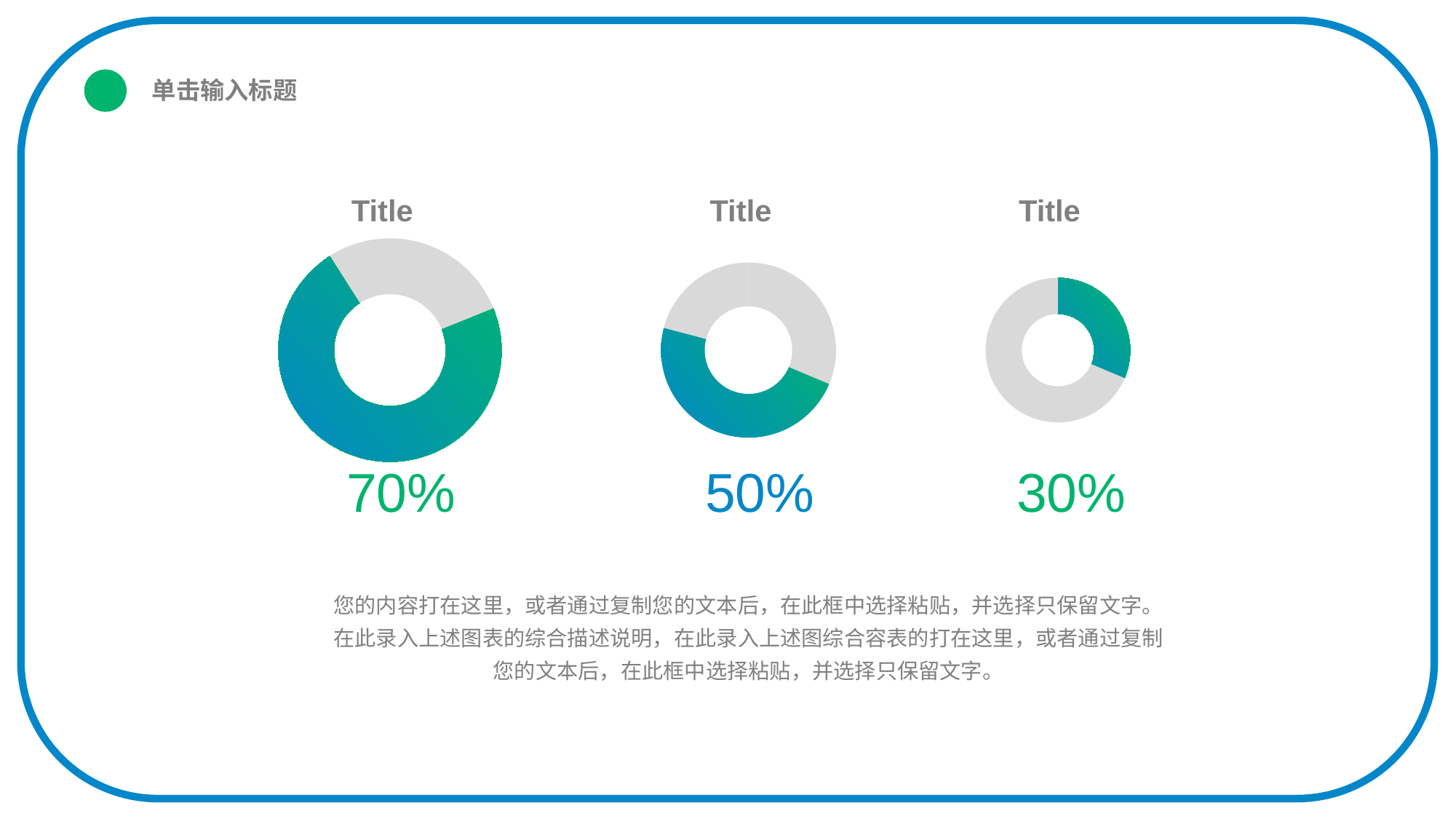
What kind of chart is used for the three charts on the slide? donut chart Which of the three donut charts shows the lowest percentage: left, middle or right? right Which of the three donut charts shows the highest percentage: left, middle or right? left What percentage is shown below the middle donut chart? 50% What title is shown above each of the three donut charts? Title What percentage is shown below the right donut chart? 30% What percentage is shown below the left donut chart? 70% What is the difference between the percentage of the left donut chart and the percentage of the right donut chart? 40% Which is larger, the percentage of the middle donut chart or the percentage of the right donut chart? middle How many donut charts are on the slide? 3 What is the difference between the percentage of the middle donut chart and the percentage of the right donut chart? 20%